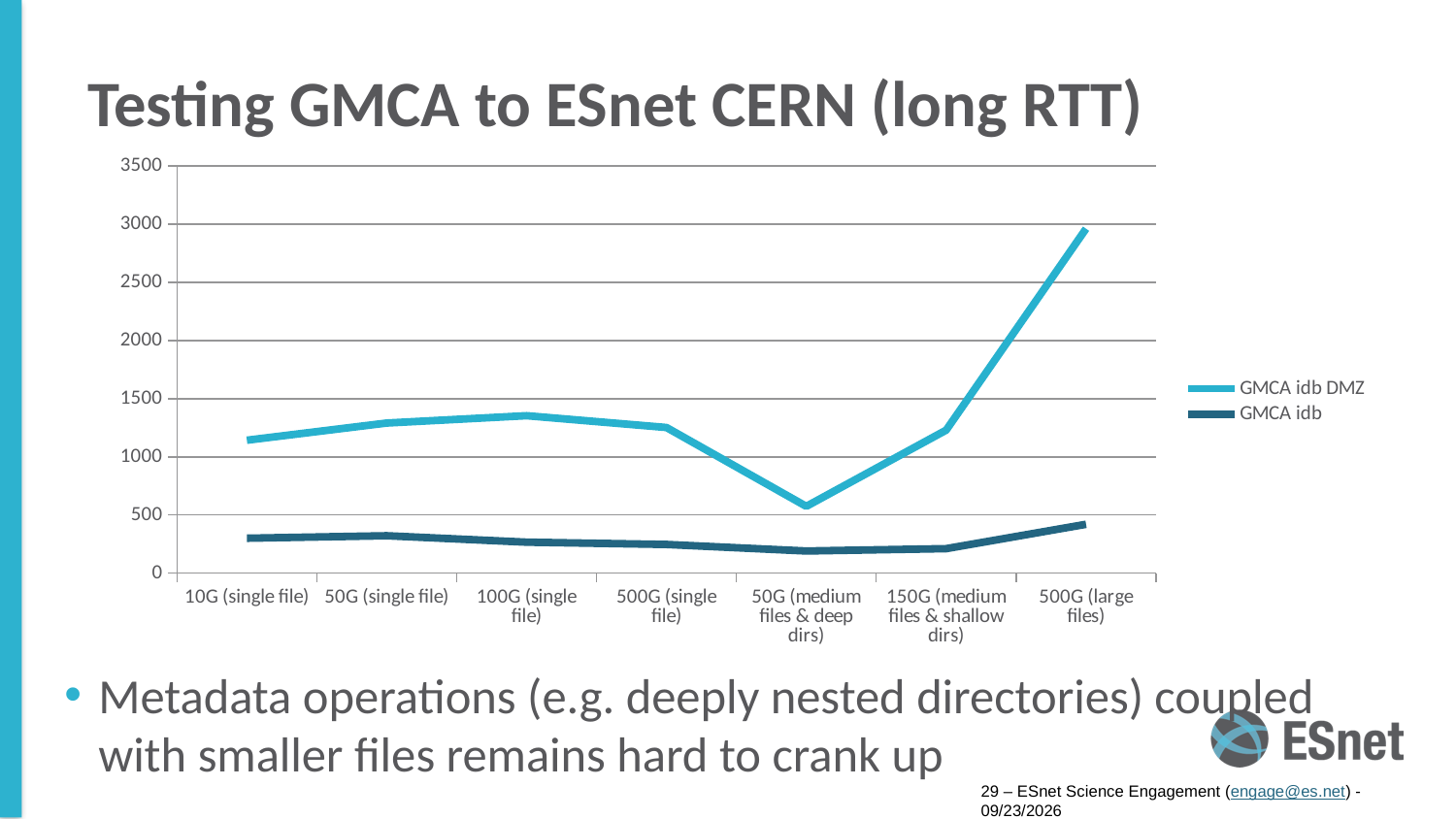
How many series does the legend list? 2 Is the GMCA idb value for 10G (single file) greater or less than 500? less Does the GMCA idb DMZ series rise or fall from 50G (medium files & deep dirs) to 500G (large files)? rise Which category has the lowest value for the GMCA idb DMZ series? 50G (medium files & deep dirs) Is the GMCA idb DMZ value for 50G (medium files & deep dirs) greater or less than 1000? less What is the title of the chart slide? Testing GMCA to ESnet CERN (long RTT) Which series has the larger value at 100G (single file), GMCA idb DMZ or GMCA idb? GMCA idb DMZ Which category has the highest value for the GMCA idb series? 500G (large files) Which category has the highest value for the GMCA idb DMZ series? 500G (large files) How many categories are plotted along the x axis? 7 What kind of chart is shown on the slide? line chart Is the GMCA idb DMZ value for 500G (large files) greater or less than 2500? greater